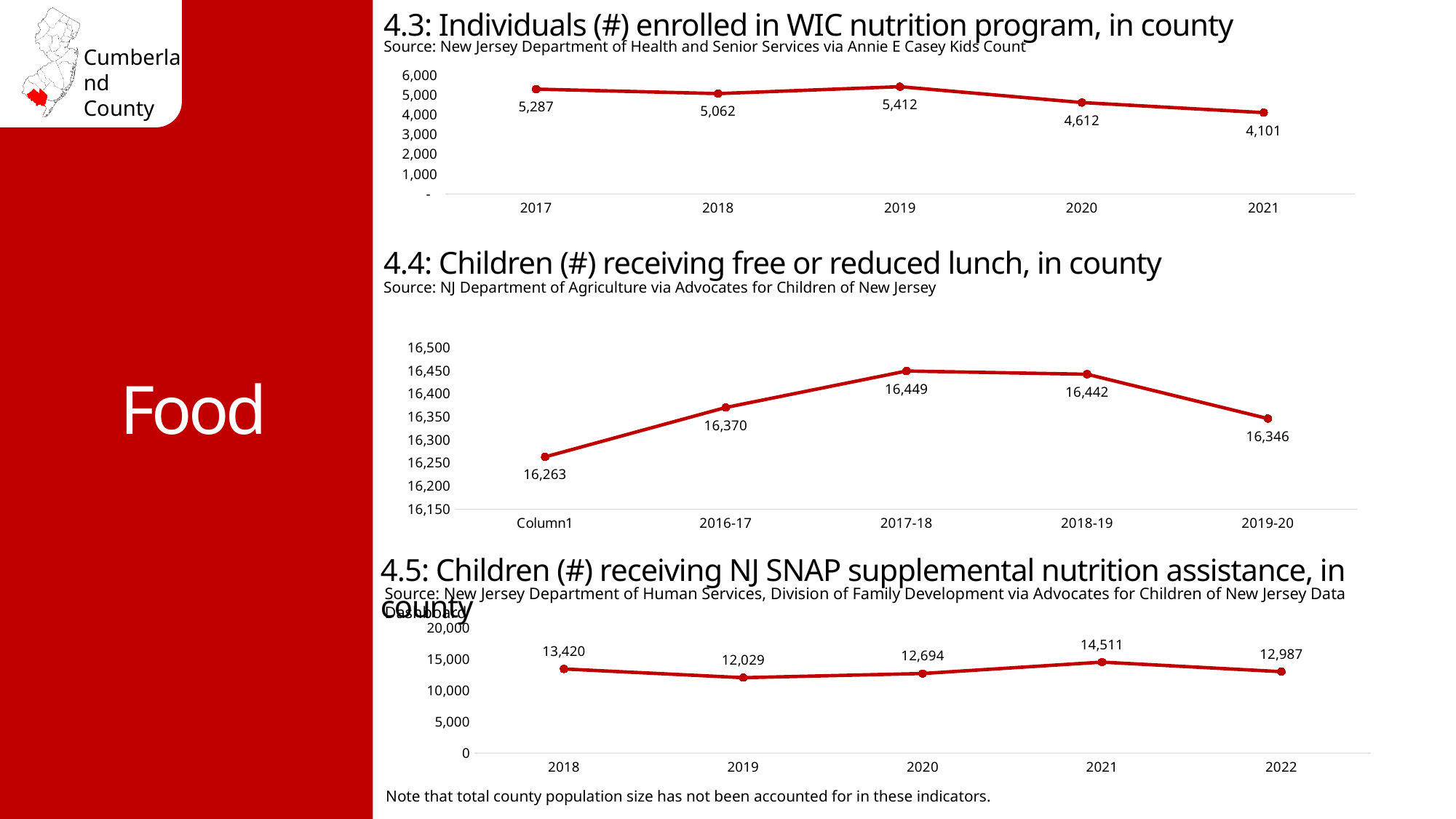
In the chart '4.4: Children (#) receiving free or reduced lunch, in county', which category has the highest value? 2017-18 What type of chart is '4.4: Children (#) receiving free or reduced lunch, in county'? Line chart In the chart '4.3: Individuals (#) enrolled in WIC nutrition program, in county', what is the difference between the 2017 and 2021 values? 1,186 In the chart '4.3: Individuals (#) enrolled in WIC nutrition program, in county', what is the value for 2019? 5,412 In the chart '4.5: Children (#) receiving NJ SNAP supplemental nutrition assistance, in county', what is the difference between the 2021 and 2022 values? 1,524 In the chart '4.4: Children (#) receiving free or reduced lunch, in county', what is the value for 2016-17? 16,370 In the chart '4.5: Children (#) receiving NJ SNAP supplemental nutrition assistance, in county', what is the value for 2021? 14,511 In the chart '4.4: Children (#) receiving free or reduced lunch, in county', which is larger, the value for 2016-17 or the value for 2019-20? 2016-17 In the chart '4.3: Individuals (#) enrolled in WIC nutrition program, in county', which year has the lowest value? 2021 In the chart '4.5: Children (#) receiving NJ SNAP supplemental nutrition assistance, in county', which year has the lowest value? 2019 In the chart '4.3: Individuals (#) enrolled in WIC nutrition program, in county', do the values rise or fall from 2019 to 2021? Fall In the chart '4.3: Individuals (#) enrolled in WIC nutrition program, in county', how many years are plotted? 5